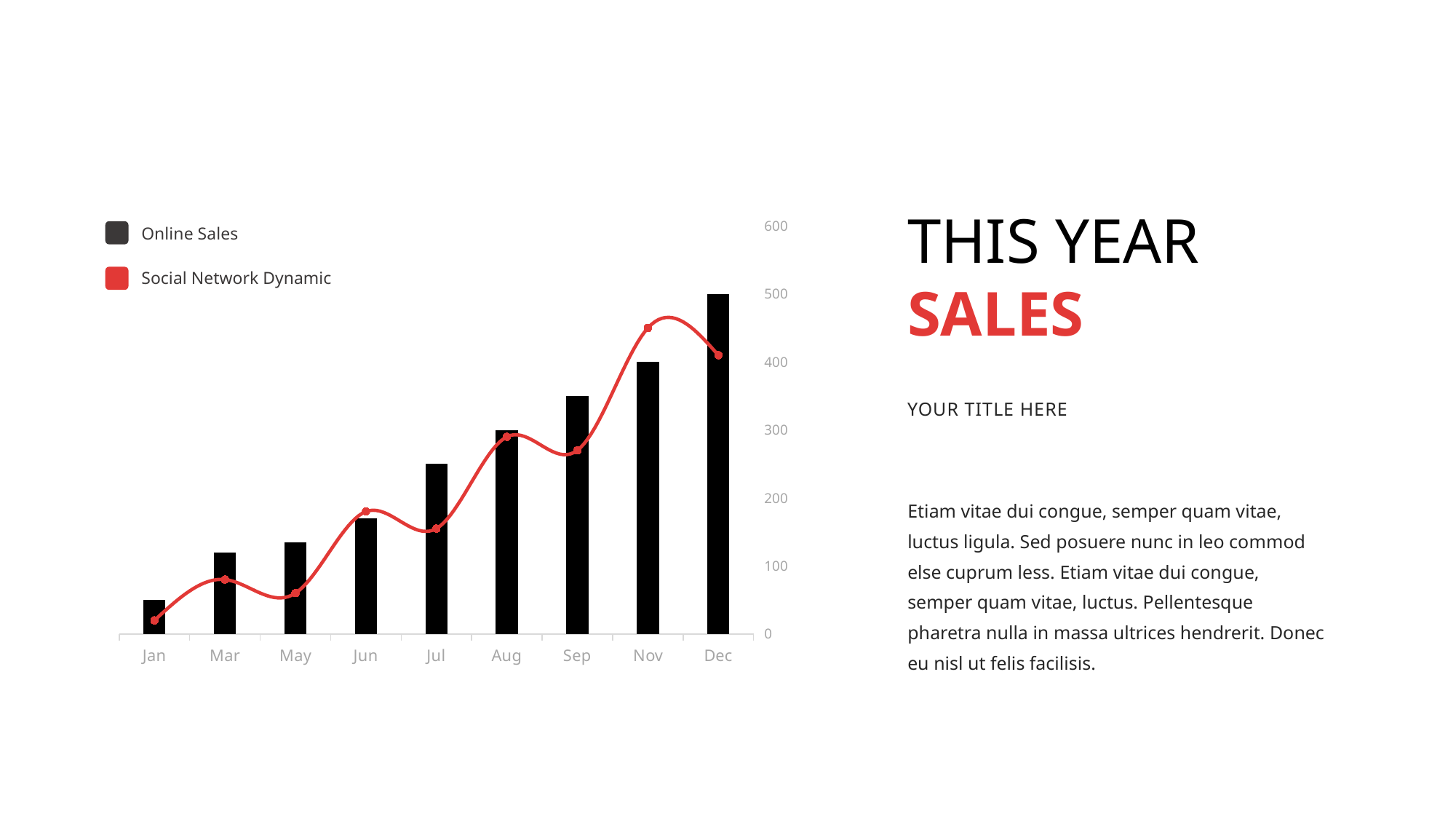
How many series does the legend list? 2 How many months are shown on the x axis? 9 What kind of chart is shown on the slide? A bar chart combined with a line Which month has the highest Online Sales bar? Dec Is the Online Sales value for Jul greater or less than 200? greater Is the Social Network Dynamic value for Nov greater or less than 400? greater Which is larger for Social Network Dynamic, Nov or Dec? Nov Do the Online Sales bars rise or fall from Jan to Dec? rise Is the Social Network Dynamic value for Jan greater or less than 100? less What is the Online Sales value for Dec? 500 Which month has the lowest Online Sales bar? Jan What colour represents Social Network Dynamic in the legend? Red